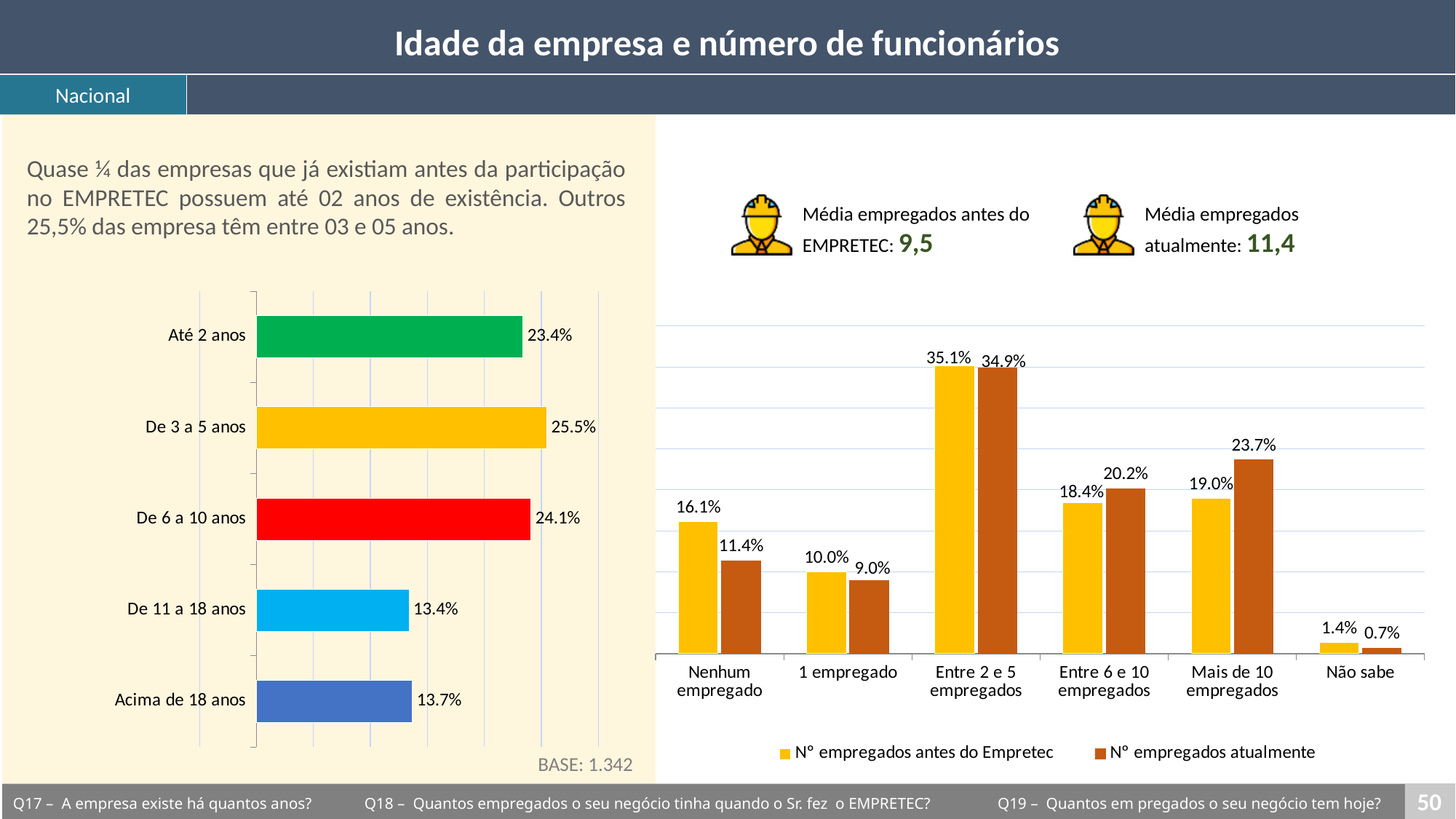
What type of chart is the left chart on company age? Bar chart In the right chart on number of employees, what is the value for 'Nº empregados atualmente' in the 'Mais de 10 empregados' category? 23.7% In the left chart on company age, what is the difference between 'De 6 a 10 anos' and 'De 11 a 18 anos'? 10.7 percentage points In the right chart on number of employees, what is the value for 'Nº empregados antes do Empretec' in the 'Nenhum empregado' category? 16.1% In the right chart on number of employees, which category has the lowest value for 'Nº empregados atualmente'? Não sabe In the right chart on number of employees, which category has the highest value for 'Nº empregados antes do Empretec'? Entre 2 e 5 empregados In the left chart on company age, how many age categories are shown? 5 In the right chart on number of employees, which is larger for 'Entre 6 e 10 empregados': the value before Empretec or the current value? Nº empregados atualmente In the right chart on number of employees, what is the difference between the two series in the 'Nenhum empregado' category? 4.7 percentage points In the right chart on number of employees, how many series does the legend list? 2 In the left chart on company age, which age category has the highest percentage? De 3 a 5 anos In the left chart on company age, what percentage of companies are 'De 3 a 5 anos'? 25.5%